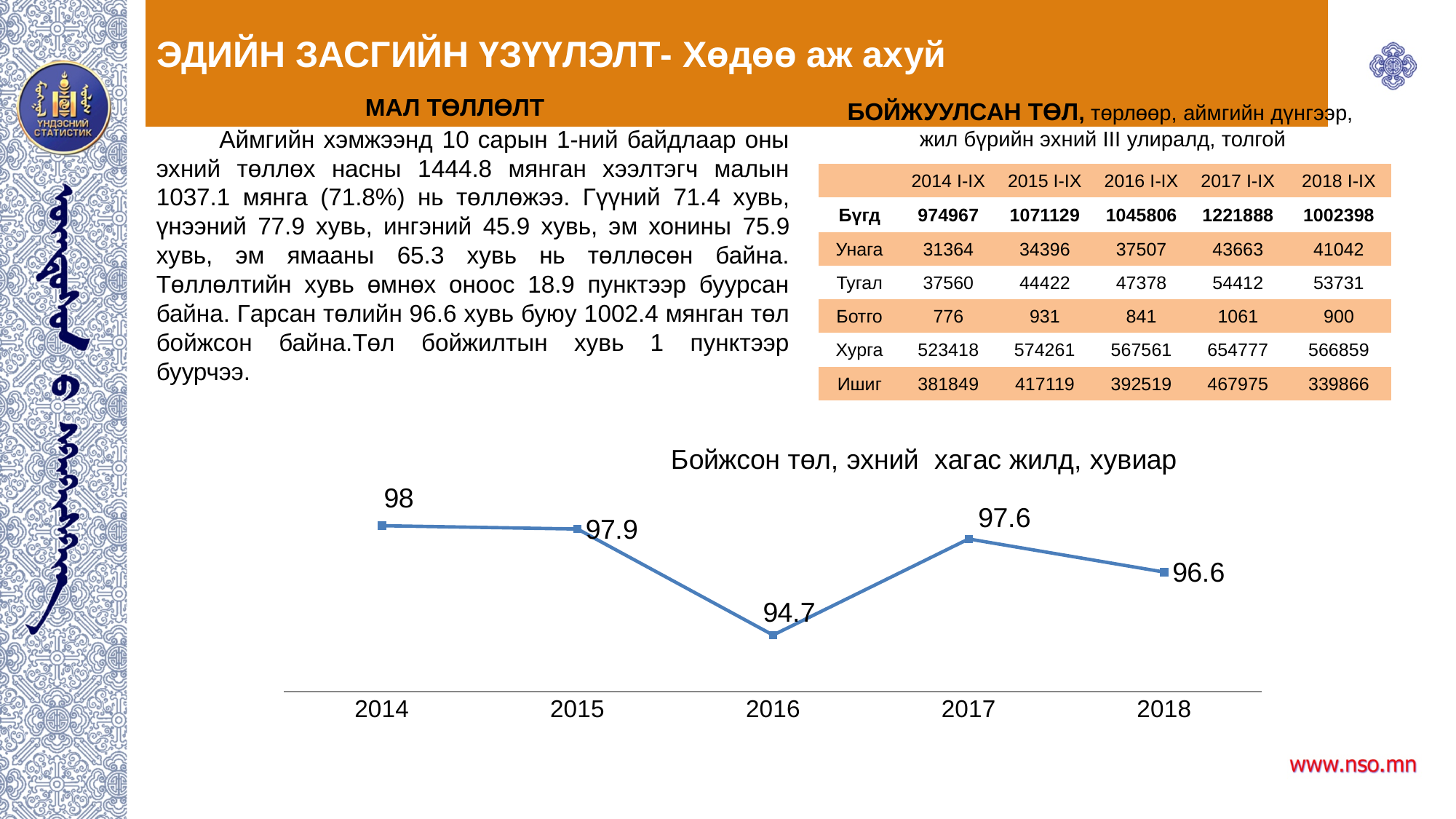
How many years are plotted in the line chart? 5 Which year has the highest value in the line chart? 2014 What kind of chart is shown at the bottom of the slide? line chart What is the value for 2017 in the line chart? 97.6 Which year has the lowest value in the line chart? 2016 What is the difference between the values for 2014 and 2016 in the line chart? 3.3 What is the title of the line chart? Бойжсон төл, эхний хагас жилд, хувиар What is the value for 2014 in the line chart? 98 Which is larger in the line chart, the value for 2015 or the value for 2018? 2015 What is the value for 2018 in the line chart? 96.6 What is the difference between the values for 2017 and 2018 in the line chart? 1 What is the value for 2016 in the line chart? 94.7